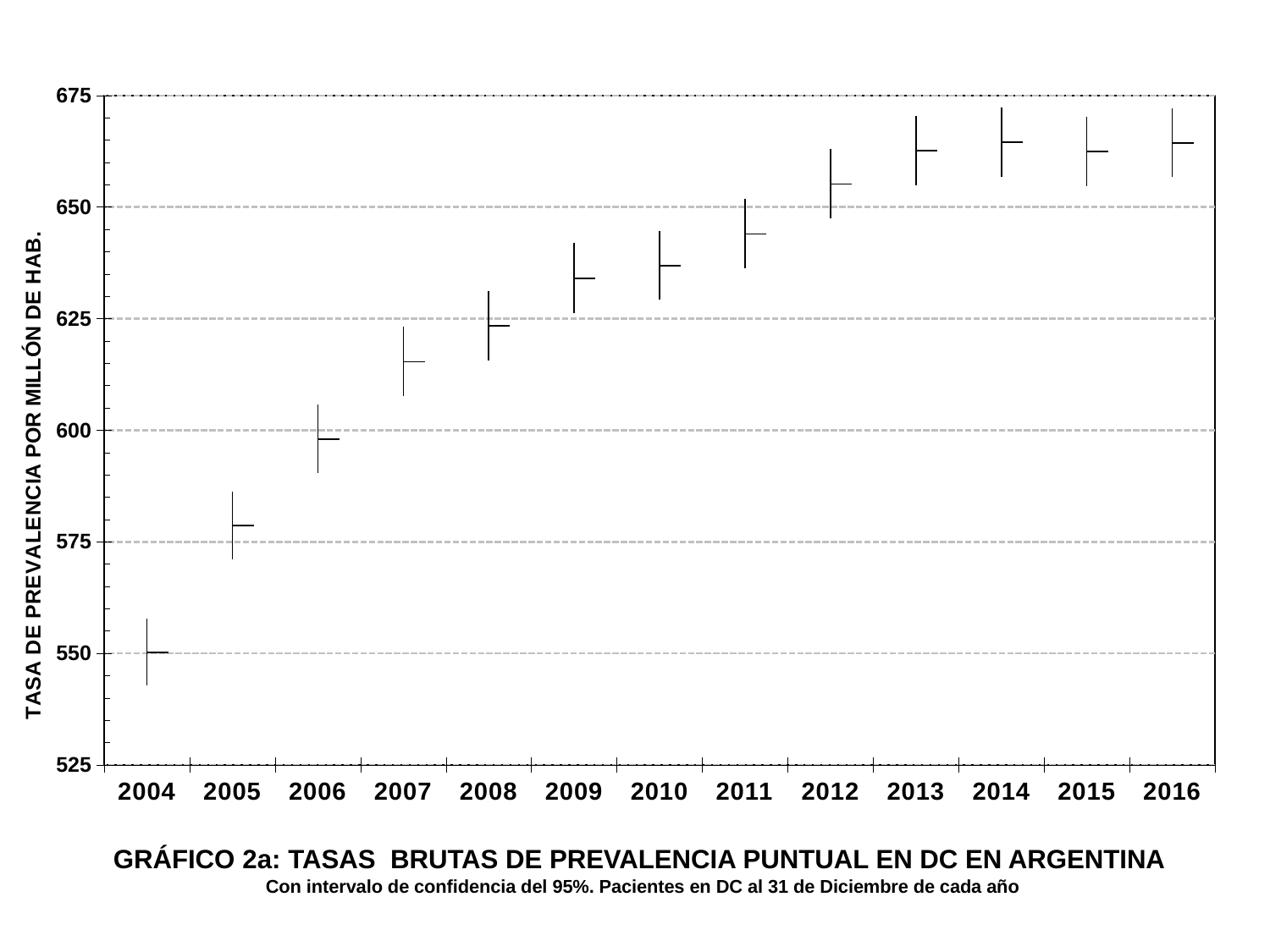
What is the title of the chart? GRÁFICO 2a: TASAS BRUTAS DE PREVALENCIA PUNTUAL EN DC EN ARGENTINA How many years are plotted on the x axis of the chart? 13 Is the value for 2007 greater or less than 600? greater Is the value for 2007 greater or less than 625? less Do the prevalence rates generally rise or fall from 2004 to 2016? rise Which year has the larger prevalence rate, 2005 or 2010? 2010 Is the value for 2009 greater or less than 625? greater Which year has the lowest prevalence rate in the chart? 2004 What confidence interval level is stated in the chart subtitle? 95%